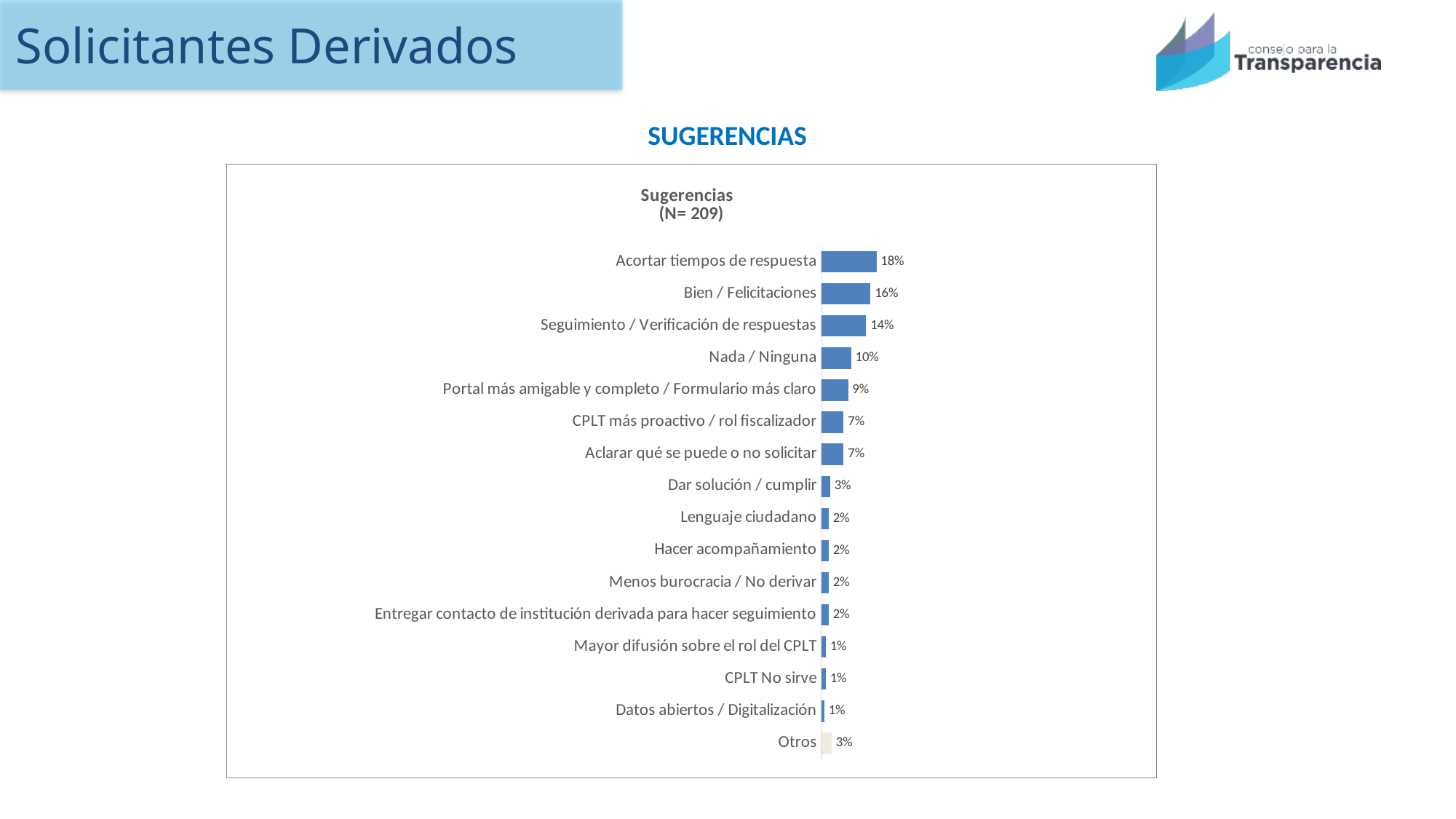
What is the difference between "Acortar tiempos de respuesta" and "Bien / Felicitaciones"? 2% What is the difference between "Seguimiento / Verificación de respuestas" and "Nada / Ninguna"? 4% What sample size (N) is stated in the chart title? 209 What value is shown for "Nada / Ninguna"? 10% Which suggestion category has the highest percentage? Acortar tiempos de respuesta What kind of chart is shown on the slide? Bar chart How many categories are plotted in the chart? 16 Which is larger, "Bien / Felicitaciones" or "Seguimiento / Verificación de respuestas"? Bien / Felicitaciones What value is shown for "CPLT más proactivo / rol fiscalizador"? 7% What percentage is shown for "Portal más amigable y completo / Formulario más claro"? 9% What percentage is shown for "Acortar tiempos de respuesta"? 18% What value is shown for "Otros"? 3%